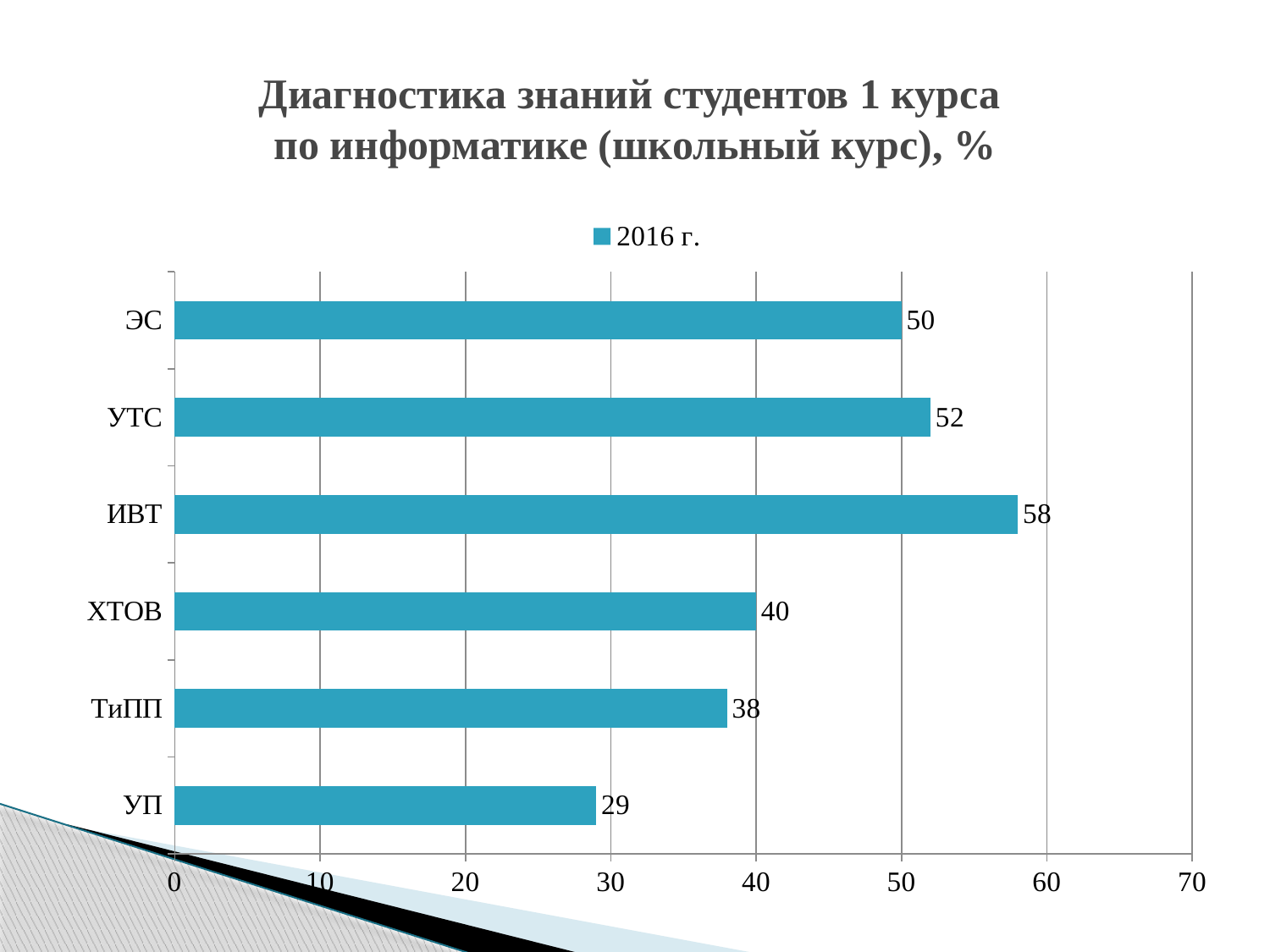
Which is larger, the value for ТиПП or the value for ХТОВ? ХТОВ What is the value for УП? 29 What is the difference between the values for ИВТ and УП? 29 What kind of chart is shown on the slide? bar chart Which category has the lowest value? УП What is the difference between the values for УТС and ЭС? 2 What series name is shown in the legend? 2016 г. How many series does the legend list? 1 What is the value for ХТОВ? 40 Which category has the highest value? ИВТ How many categories are shown in the chart? 6 What is the value for ИВТ? 58